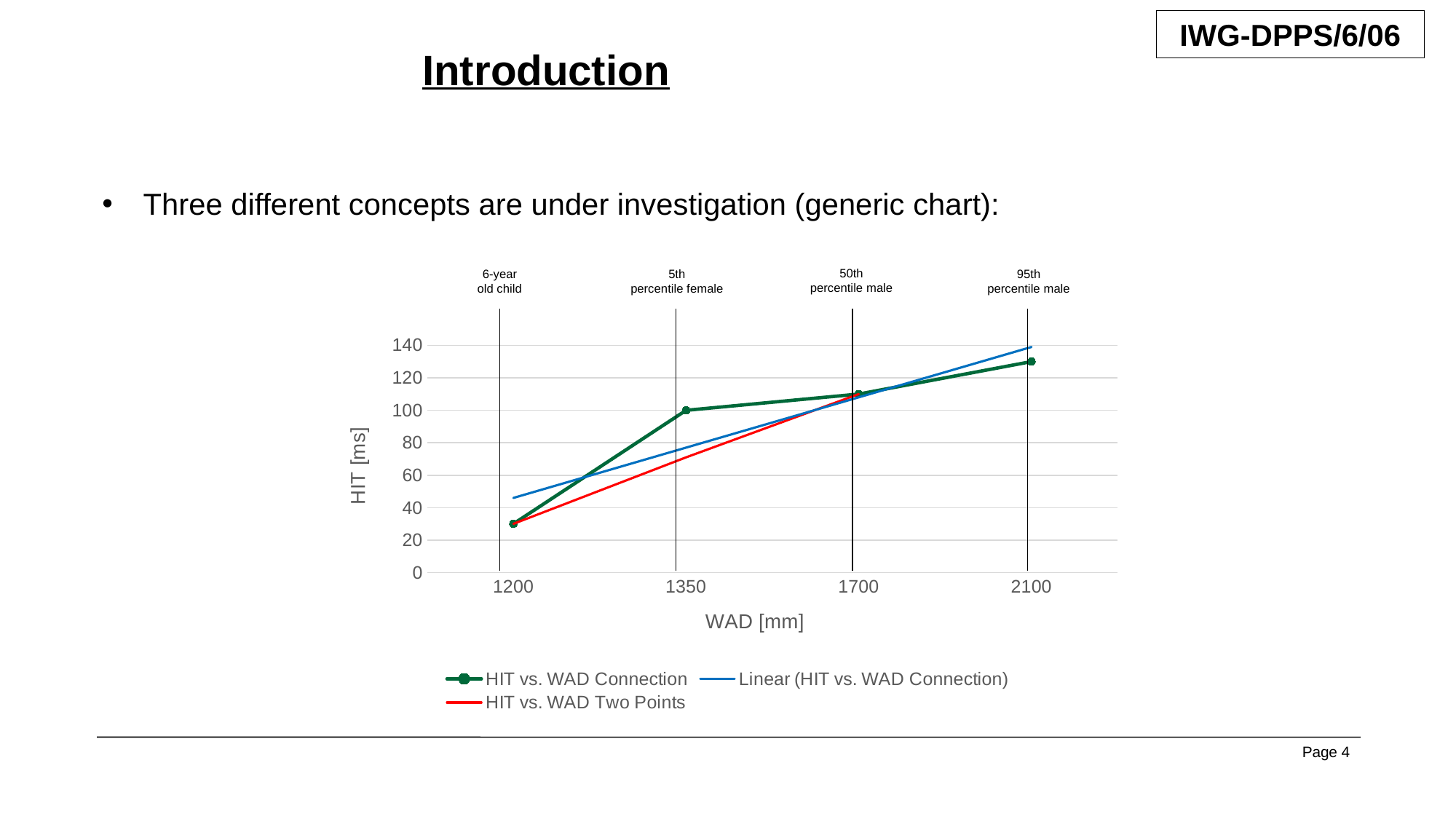
At which WAD value is the HIT vs. WAD Connection series lowest? 1200 At which WAD value is the HIT vs. WAD Connection series highest? 2100 What kind of chart is shown on the slide? line chart Is the HIT vs. WAD Connection value at WAD 1700 greater or less than 100? greater How many WAD values are marked on the x axis of the chart? 4 Is the HIT vs. WAD Connection value at WAD 2100 greater or less than 120? greater Is the HIT vs. WAD Connection value at WAD 1200 greater or less than 40? less What is the title of the y axis of the chart? HIT [ms] How many series does the chart legend list? 3 Does the HIT vs. WAD Connection series rise or fall as WAD increases? rise Which has the larger HIT vs. WAD Connection value, WAD 1200 or WAD 1350? 1350 What is the HIT value of the HIT vs. WAD Connection series at WAD 1350 mm? 100